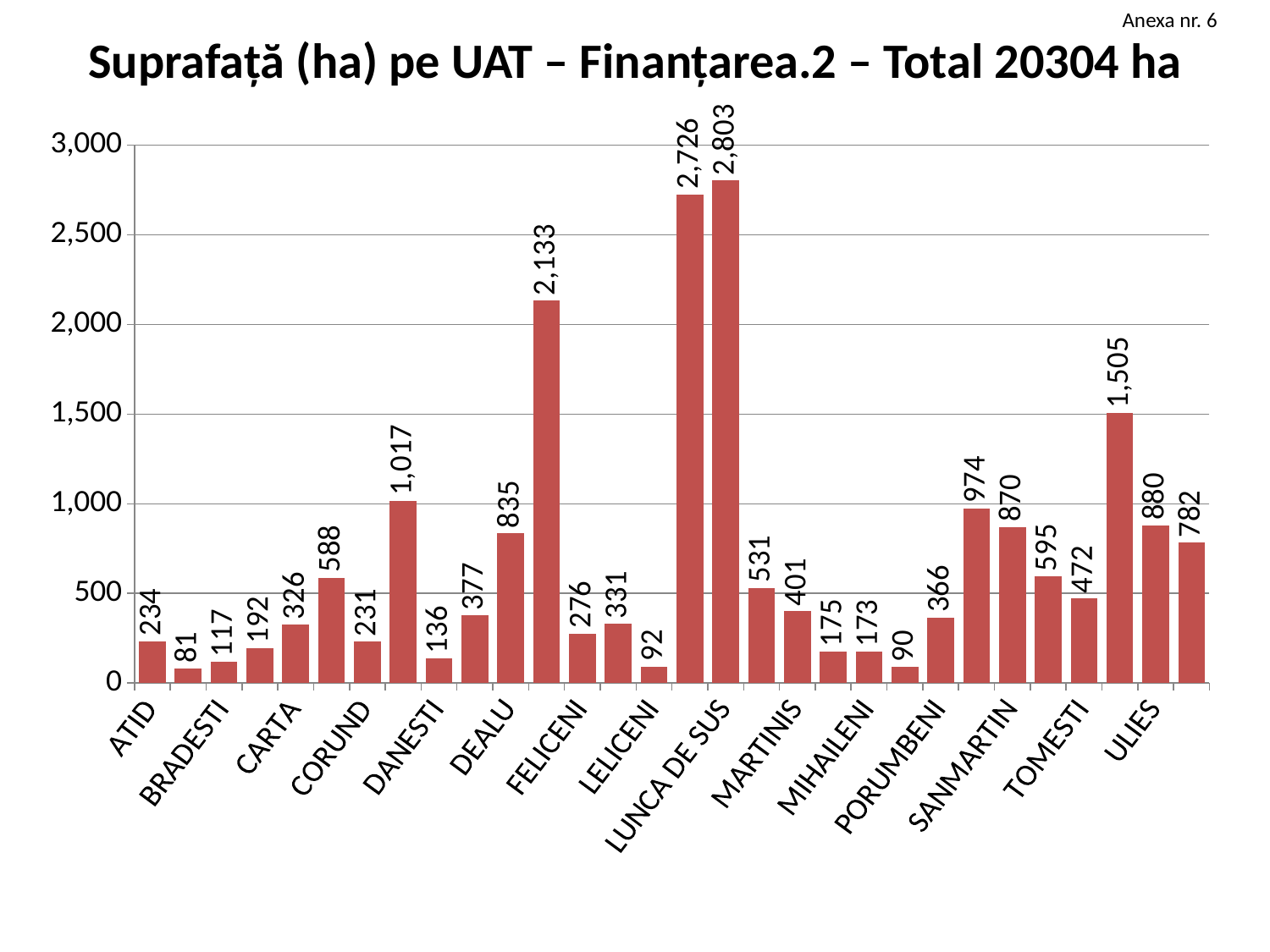
Is the value for ATID greater or less than 500? less What is the title of the chart? Suprafață (ha) pe UAT – Finanțarea.2 – Total 20304 ha What is the highest tick value shown on the vertical axis? 3,000 How many bars have values above 2,000? 3 What is the highest value shown by any bar in the chart? 2,803 What is the difference between the highest bar value (2,803) and the lowest bar value (81)? 2,722 What is the value for ATID? 234 How many bars are plotted in the chart? 30 What total area in hectares is stated in the chart title? 20304 ha Which is larger, the bar labelled 2,726 or the bar labelled 2,803? 2,803 What type of chart is shown on the slide? bar chart What is the lowest value shown by any bar in the chart? 81